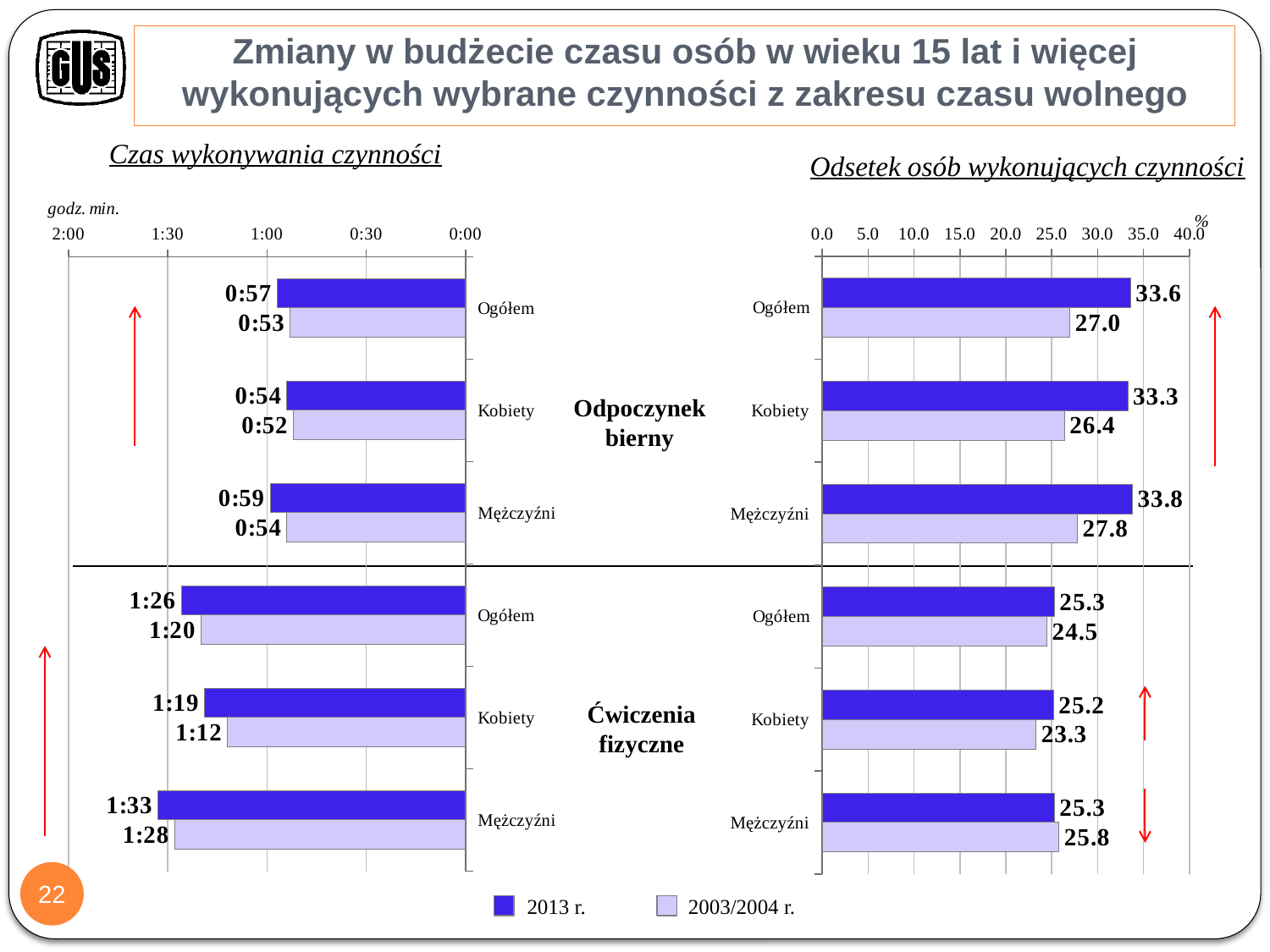
In the 'Czas wykonywania czynności' chart, which group has the lowest 2003/2004 r. value? Kobiety (Odpoczynek bierny) In the 'Odsetek osób wykonujących czynności' chart, for Mężczyźni under Ćwiczenia fizyczne, which is larger: the 2013 r. value or the 2003/2004 r. value? 2003/2004 r. How many series does the legend list? 2 In the 'Odsetek osób wykonujących czynności' chart, what is the difference between the 2013 r. and 2003/2004 r. values for Ogółem under Odpoczynek bierny? 6.6 What unit is shown on the axis of the 'Odsetek osób wykonujących czynności' chart? % In the 'Odsetek osób wykonujących czynności' chart, what is the 2003/2004 r. value for Kobiety under Odpoczynek bierny? 26.4 In the 'Odsetek osób wykonujących czynności' chart, is the 2013 r. value for Kobiety under Ćwiczenia fizyczne greater or less than 30.0? less In the 'Czas wykonywania czynności' chart, what is the 2013 r. value for Mężczyźni under Ćwiczenia fizyczne? 1:33 In the 'Czas wykonywania czynności' chart, what is the 2003/2004 r. value for Ogółem under Odpoczynek bierny? 0:53 What kind of chart is the 'Czas wykonywania czynności' chart? bar chart In the 'Odsetek osób wykonujących czynności' chart, which group has the highest 2013 r. value? Mężczyźni (Odpoczynek bierny) In the 'Czas wykonywania czynności' chart, for Kobiety under Ćwiczenia fizyczne, which is larger: the 2013 r. value or the 2003/2004 r. value? 2013 r.